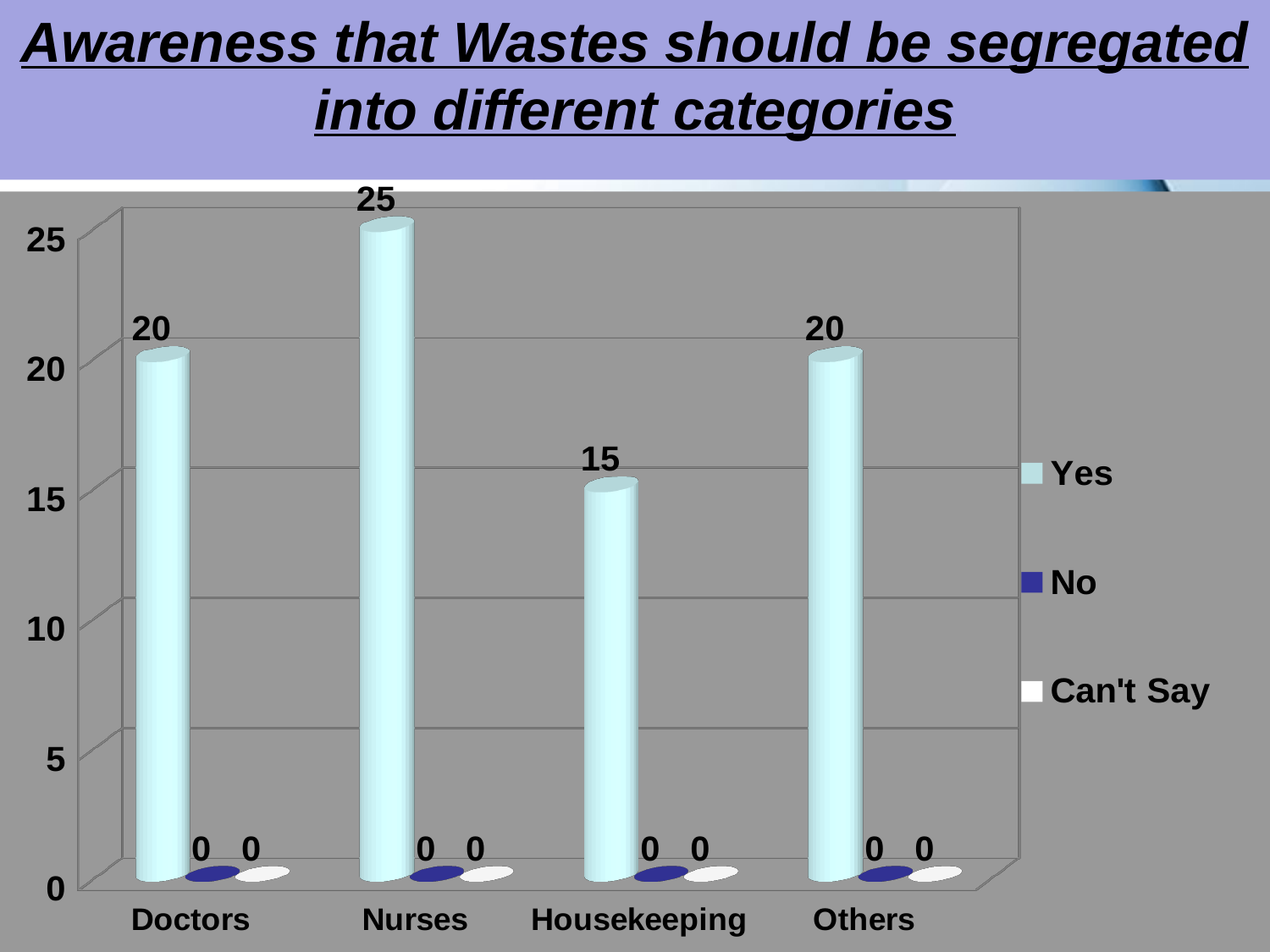
What is the title of the slide? Awareness that Wastes should be segregated into different categories Which category has the lowest 'Yes' value? Housekeeping How many series does the legend list? 3 What is the difference between the 'Yes' values for Nurses and Housekeeping? 10 What is the 'Yes' value for Housekeeping? 15 What is the 'Can't Say' value for Others? 0 What kind of chart is shown on the slide? Bar chart What is the 'No' value for Doctors? 0 Which has a larger 'Yes' value, Doctors or Housekeeping? Doctors What is the 'Yes' value for Nurses? 25 How many categories are shown on the x axis? 4 Which category has the highest 'Yes' value? Nurses